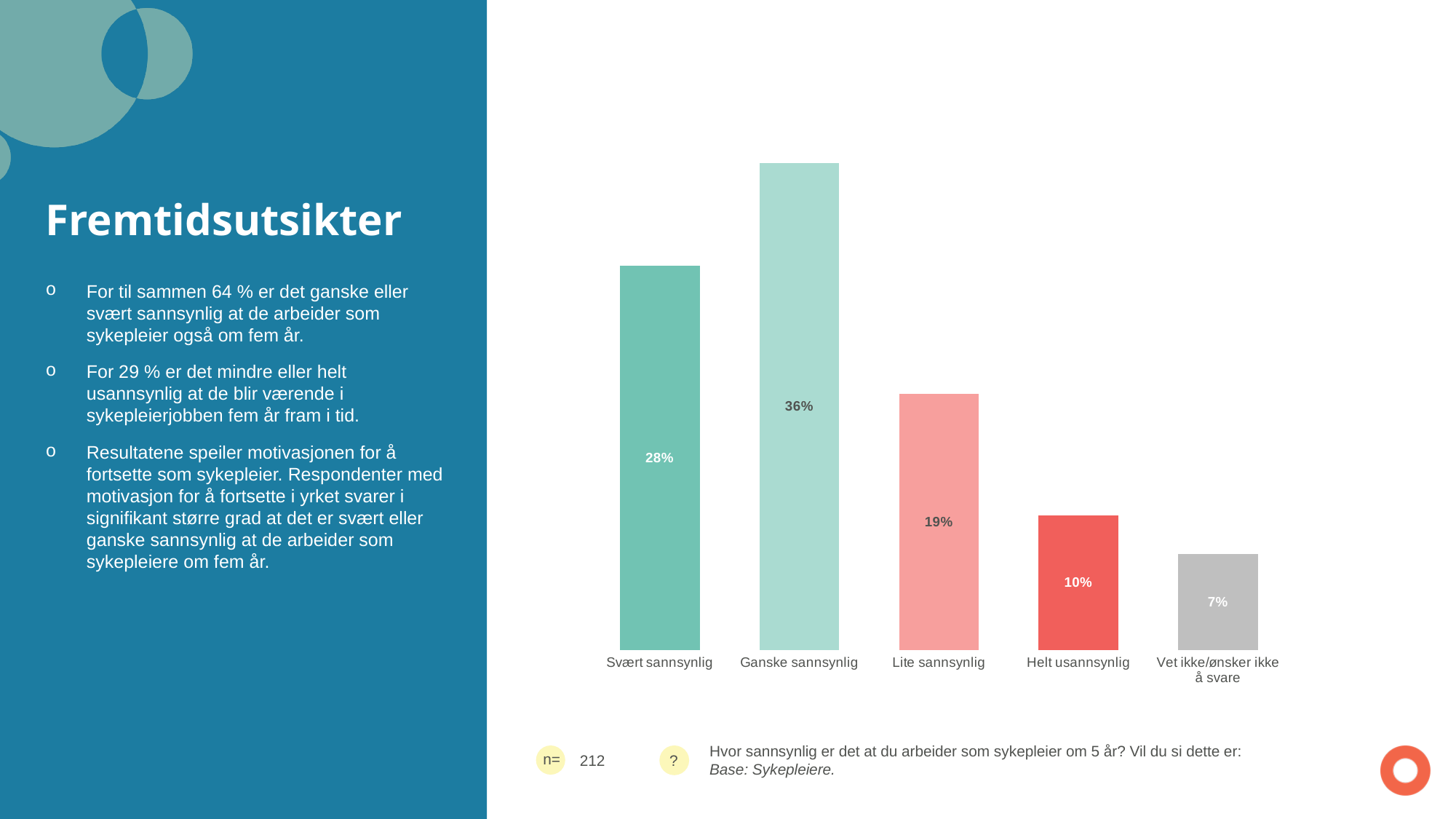
Which is larger, Svært sannsynlig or Lite sannsynlig? Svært sannsynlig What is the value for Svært sannsynlig? 28% What kind of chart is shown on the slide? Bar chart What is the value for Helt usannsynlig? 10% What is the value for Ganske sannsynlig? 36% What is the value for Vet ikke/ønsker ikke å svare? 7% Which category has the lowest value? Vet ikke/ønsker ikke å svare What is the value for Lite sannsynlig? 19% What is the difference between Lite sannsynlig and Helt usannsynlig? 9% How many categories are shown in the chart? 5 What is the difference between Ganske sannsynlig and Svært sannsynlig? 8% Which category has the highest value? Ganske sannsynlig